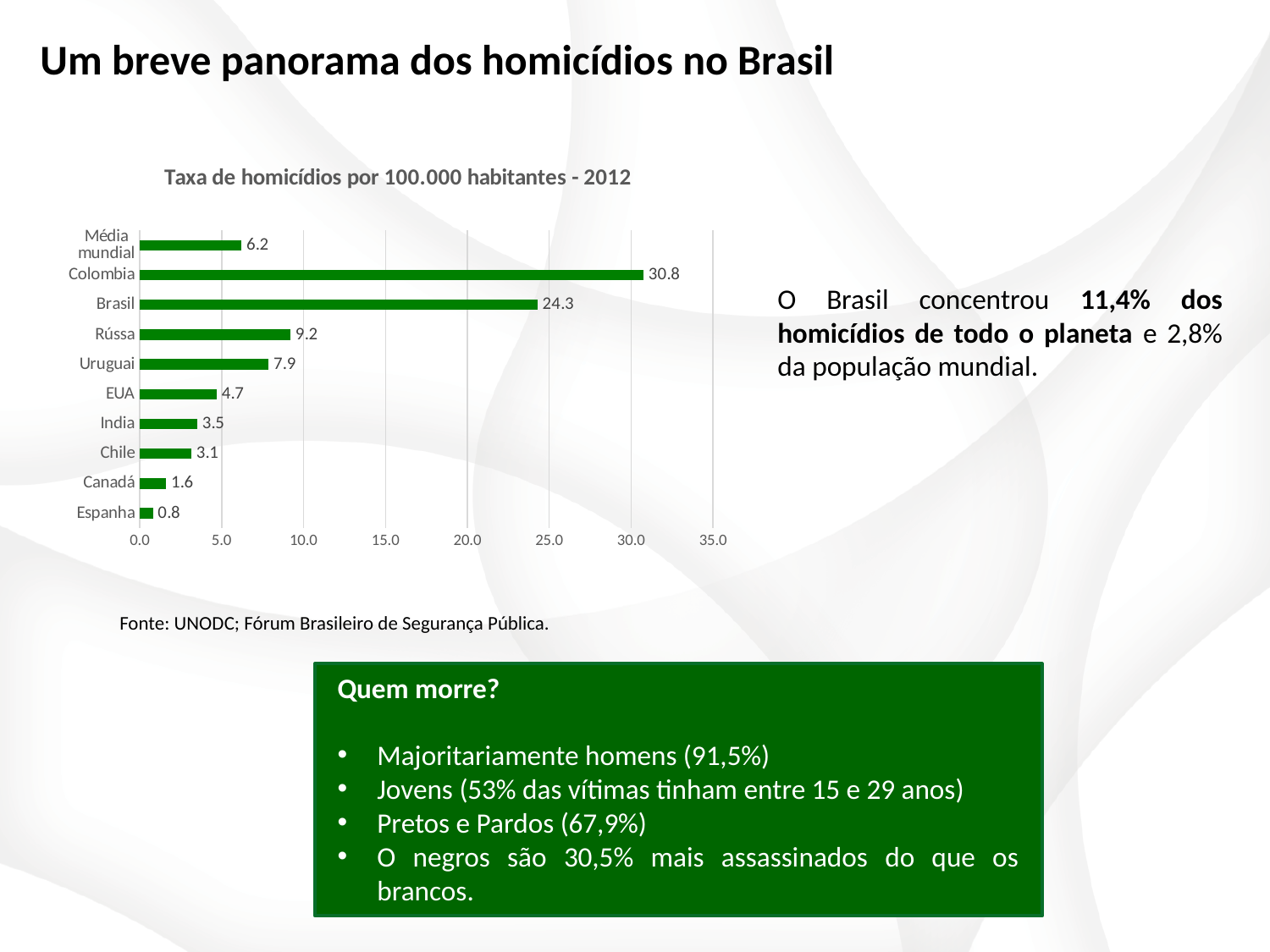
What is the value shown for Média mundial? 6.2 Which has a higher homicide rate, Chile or Canadá? Chile What is the difference between the homicide rates of Colombia and Brasil? 6.5 What is the difference between the homicide rates of Brasil and Média mundial? 18.1 How many categories are shown in the chart? 10 Which country has the lowest homicide rate in the chart? Espanha Which has a higher homicide rate, Uruguai or EUA? Uruguai What is the homicide rate per 100,000 inhabitants for Brasil? 24.3 What type of chart is shown on the slide? Bar chart Which country has the highest homicide rate in the chart? Colombia What is the value shown for Rússa? 9.2 What is the title of the chart? Taxa de homicídios por 100.000 habitantes - 2012